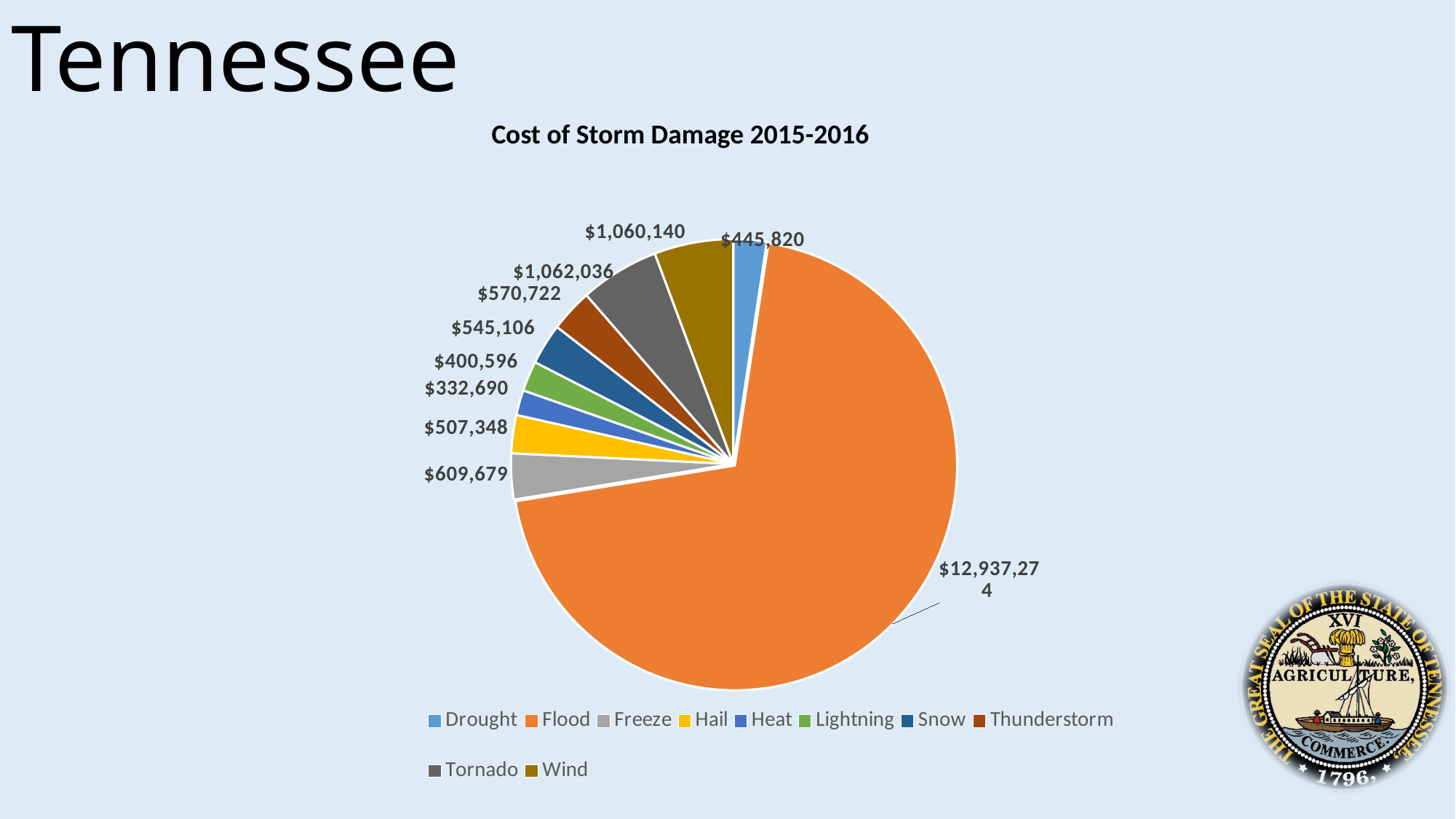
What is the cost of storm damage for Heat? $332,690 Which storm type has the lowest cost of damage? Heat Which storm type has the highest cost of damage? Flood What is the cost of storm damage for Flood? $12,937,274 What is the difference between the Tornado and Wind damage costs? $1,896 What is the cost of storm damage for Snow? $545,106 What kind of chart is shown on the slide? Pie chart How many storm types are shown in the pie chart? 10 What is the cost of storm damage for Tornado? $1,062,036 What is the title of the chart? Cost of Storm Damage 2015-2016 Which has a higher damage cost, Freeze or Hail? Freeze What is the cost of storm damage for Drought? $445,820